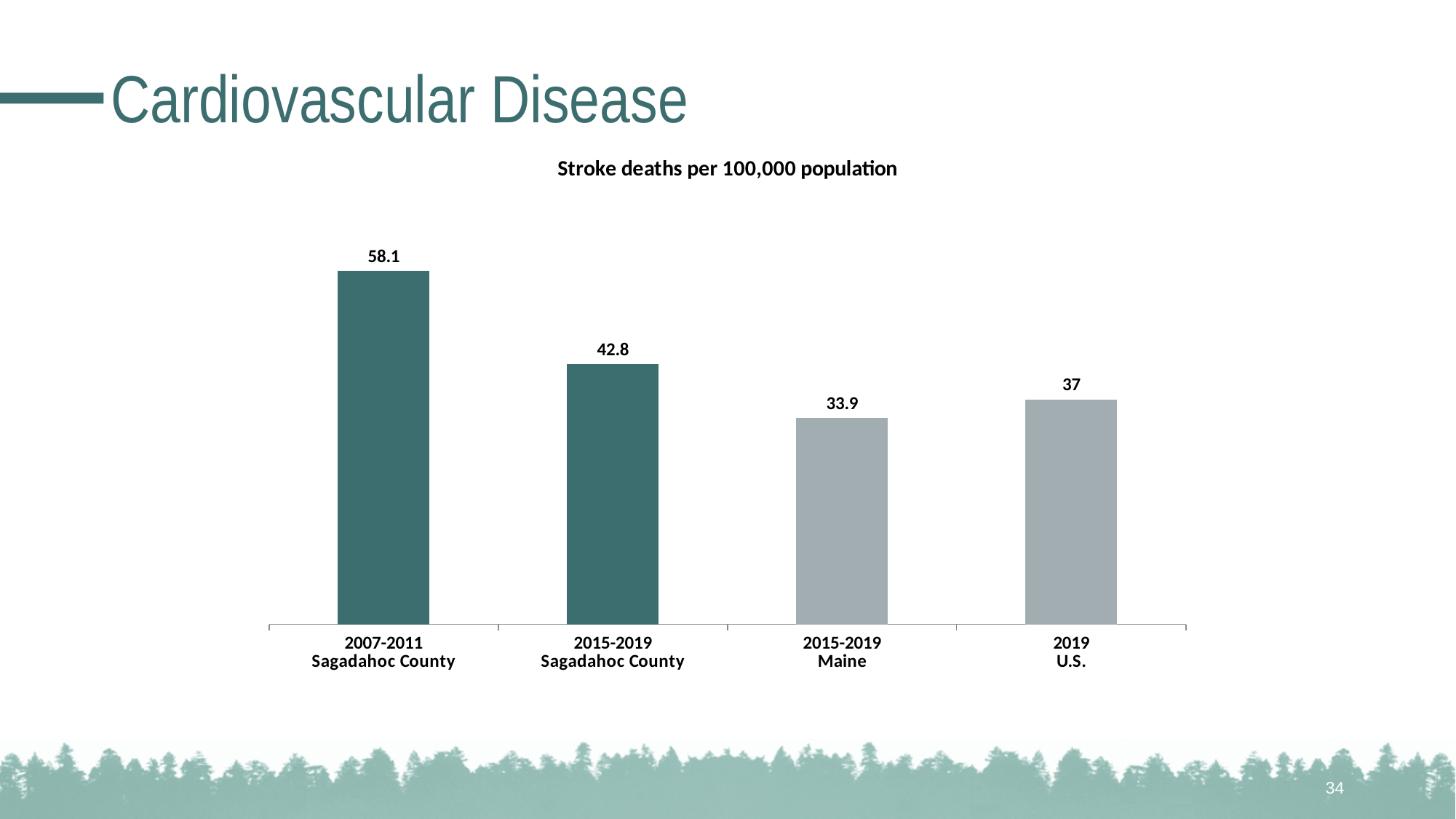
What is the stroke death rate per 100,000 population for Sagadahoc County in 2015-2019? 42.8 What is the title of the chart? Stroke deaths per 100,000 population Which category has the lowest stroke death rate? 2015-2019 Maine What is the stroke death rate per 100,000 population for the U.S. in 2019? 37 What is the stroke death rate per 100,000 population for Sagadahoc County in 2007-2011? 58.1 What is the stroke death rate per 100,000 population for Maine in 2015-2019? 33.9 Which category has the highest stroke death rate? 2007-2011 Sagadahoc County By how much did the stroke death rate in Sagadahoc County fall from 2007-2011 to 2015-2019? 15.3 Which is larger, the 2019 U.S. stroke death rate or the 2015-2019 Maine rate? 2019 U.S. What kind of chart is shown on the slide? Bar chart How many bars are shown in the chart? 4 What is the difference between the 2015-2019 Sagadahoc County rate and the 2015-2019 Maine rate? 8.9